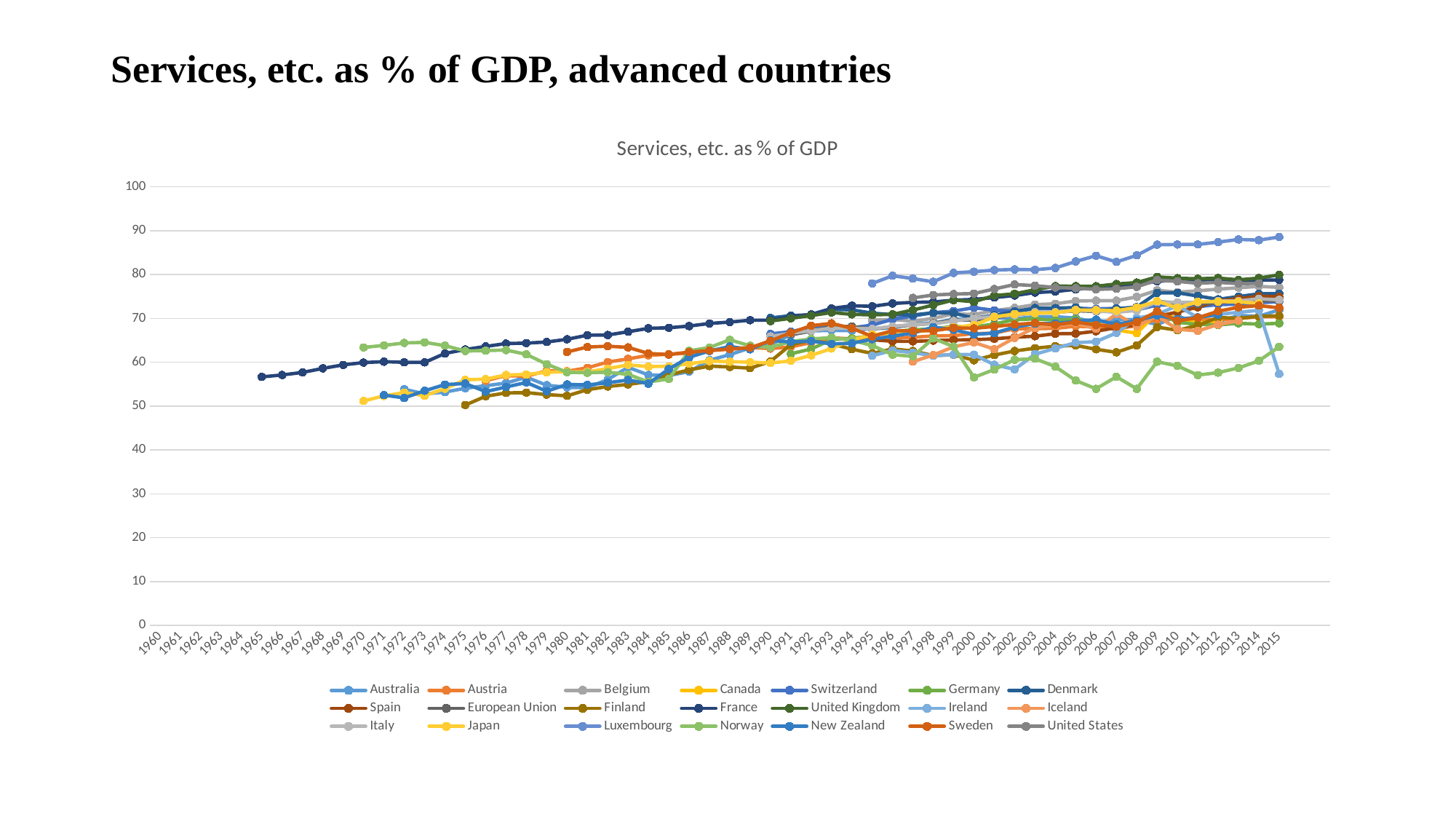
Is the value for Luxembourg in 1995 greater or less than 70? greater How many series does the legend list? 21 What kind of chart is shown on the slide? line chart Which is larger in 2015, the value for Luxembourg or the value for Norway? Luxembourg Does the Luxembourg series generally rise or fall from 1995 to 2015? rise What is the title shown inside the chart area? Services, etc. as % of GDP Is the value for Norway in 2006 greater or less than 60? less Is the value for Luxembourg in 2015 greater or less than 80? greater What is the highest value labelled on the y axis? 100 How many years are labelled along the x axis? 56 Which country has the highest value in 2015? Luxembourg